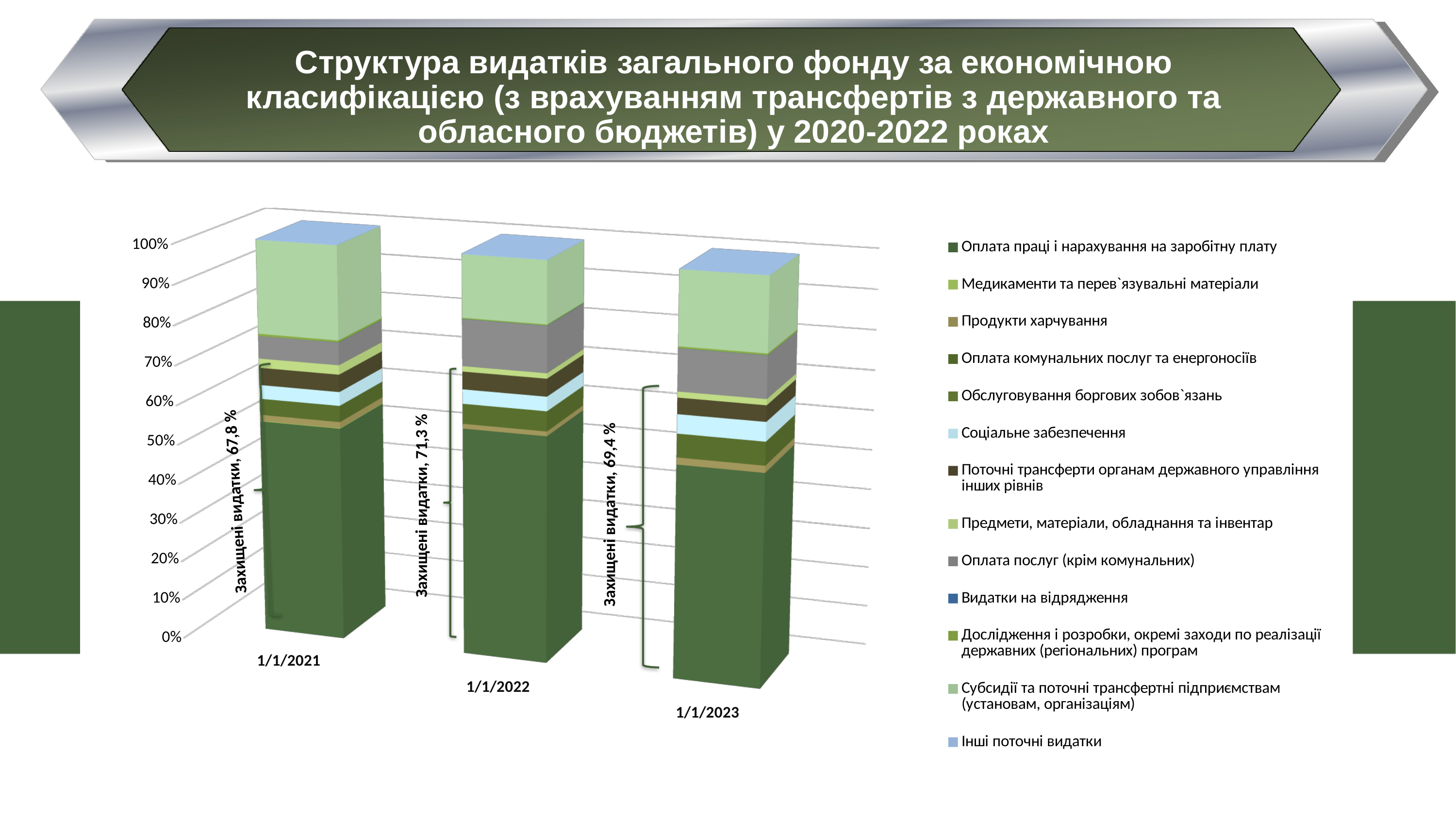
How many bars (dates) are plotted on the chart? 3 What share of protected expenditures (Захищені видатки) is annotated for 1/1/2022? 71,3 % What is the difference between the protected expenditure shares for 1/1/2022 and 1/1/2021? 3,5 % Is the protected expenditure share larger for 1/1/2023 or for 1/1/2021? 1/1/2023 What share of protected expenditures (Захищені видатки) is annotated for 1/1/2021? 67,8 % How many series does the legend list? 13 Which legend entry is listed first? Оплата праці і нарахування на заробітну плату Which date has the lowest annotated share of protected expenditures? 1/1/2021 Is the value of the 'Оплата праці і нарахування на заробітну плату' segment for 1/1/2021 greater or less than 40%? greater Which date has the highest annotated share of protected expenditures? 1/1/2022 What kind of chart is shown on the slide? Stacked bar chart What share of protected expenditures (Захищені видатки) is annotated for 1/1/2023? 69,4 %